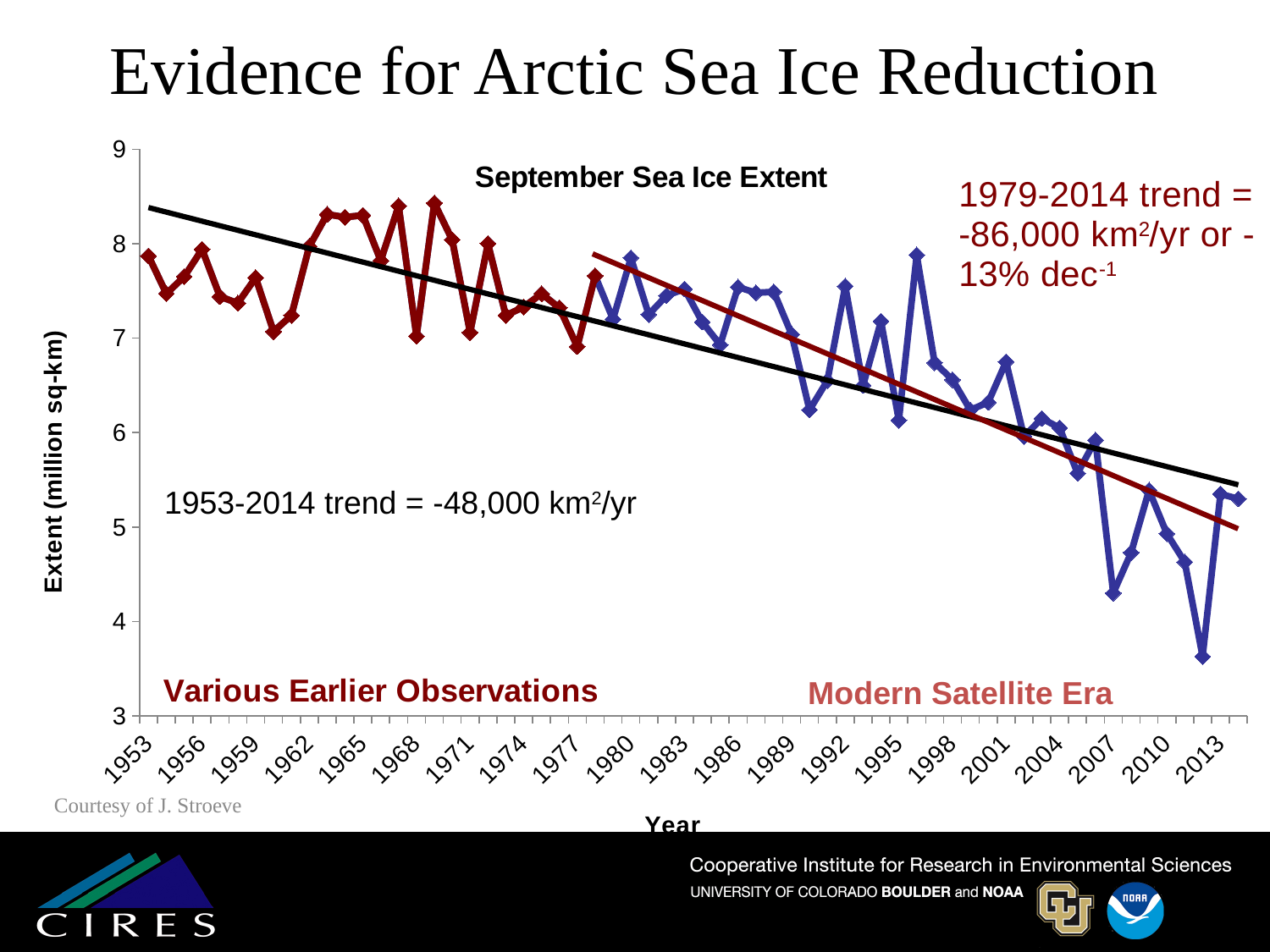
Which year has the larger September sea ice extent, 1953 or 2013? 1953 Which year has the larger September sea ice extent, 1996 or 2007? 1996 Is the September sea ice extent for 1953 greater or less than 7 million sq-km? greater What is the 1953-2014 trend stated on the chart? -48,000 km²/yr What kind of chart is shown on the slide? line chart Which year has the lowest September sea ice extent on the chart? 2012 Is the September sea ice extent for 2007 greater or less than 5 million sq-km? less Overall, do the September sea ice extent values rise or fall from 1953 to 2014? fall Is the September sea ice extent for 2005 greater or less than 6 million sq-km? less What is the 1979-2014 trend stated on the chart in km²/yr? -86,000 km²/yr